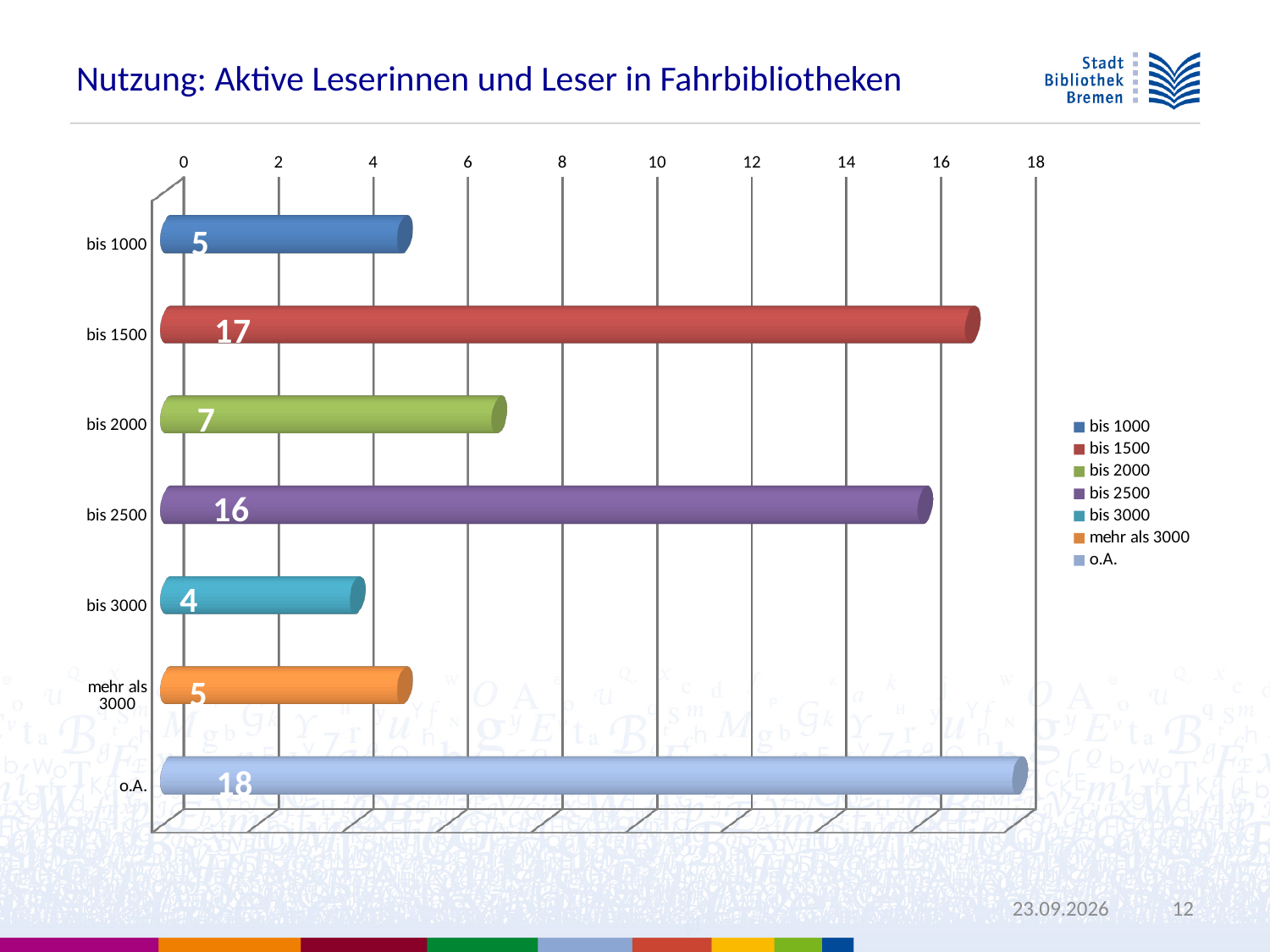
What is the title of the slide? Nutzung: Aktive Leserinnen und Leser in Fahrbibliotheken What is the value for 'bis 3000'? 4 Is the value for 'bis 2500' greater or less than 10? greater What is the difference between the values for 'bis 1500' and 'bis 2000'? 10 What is the value for 'o.A.'? 18 Which is larger, the value for 'bis 2000' or the value for 'bis 1000'? bis 2000 Which category has the highest value? o.A. What kind of chart is shown on the slide? bar chart What is the value for 'bis 1500'? 17 Which category has the lowest value? bis 3000 How many categories are shown in the chart? 7 What is the value for 'bis 2500'? 16